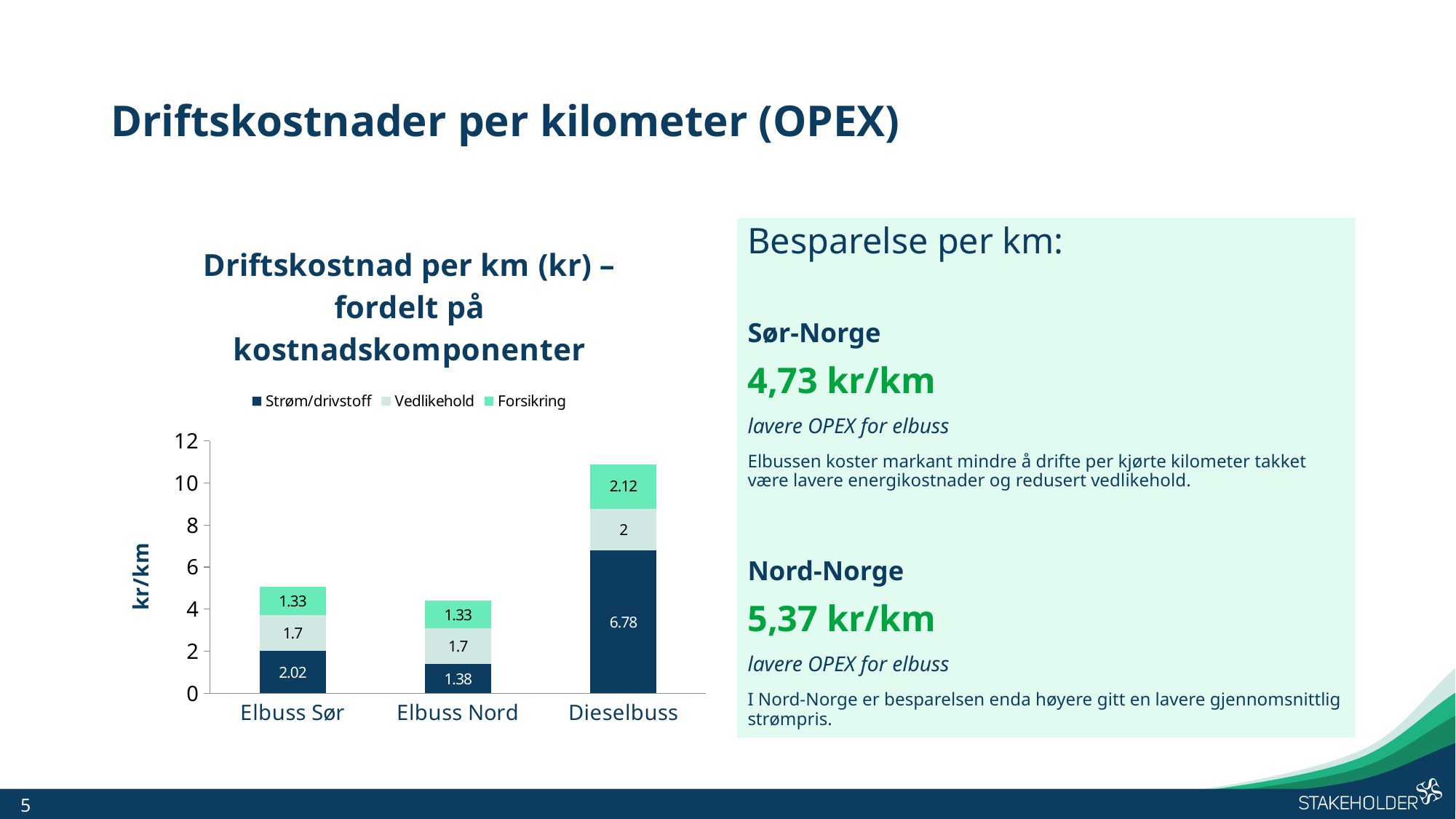
What is the Vedlikehold value for Elbuss Sør? 1.7 Which category has the highest Strøm/drivstoff value? Dieselbuss What is the Strøm/drivstoff value for Elbuss Nord? 1.38 What is the difference between the Strøm/drivstoff values for Elbuss Sør and Elbuss Nord? 0.64 What is the total stacked value for Dieselbuss? 10.9 What is the total stacked value for Elbuss Sør? 5.05 What is the Forsikring value for Dieselbuss? 2.12 How many series does the legend list? 3 What type of chart is shown on the slide? Stacked bar chart Which category has the lowest Strøm/drivstoff value? Elbuss Nord What is the Strøm/drivstoff value for Dieselbuss? 6.78 How many categories are shown on the x axis? 3